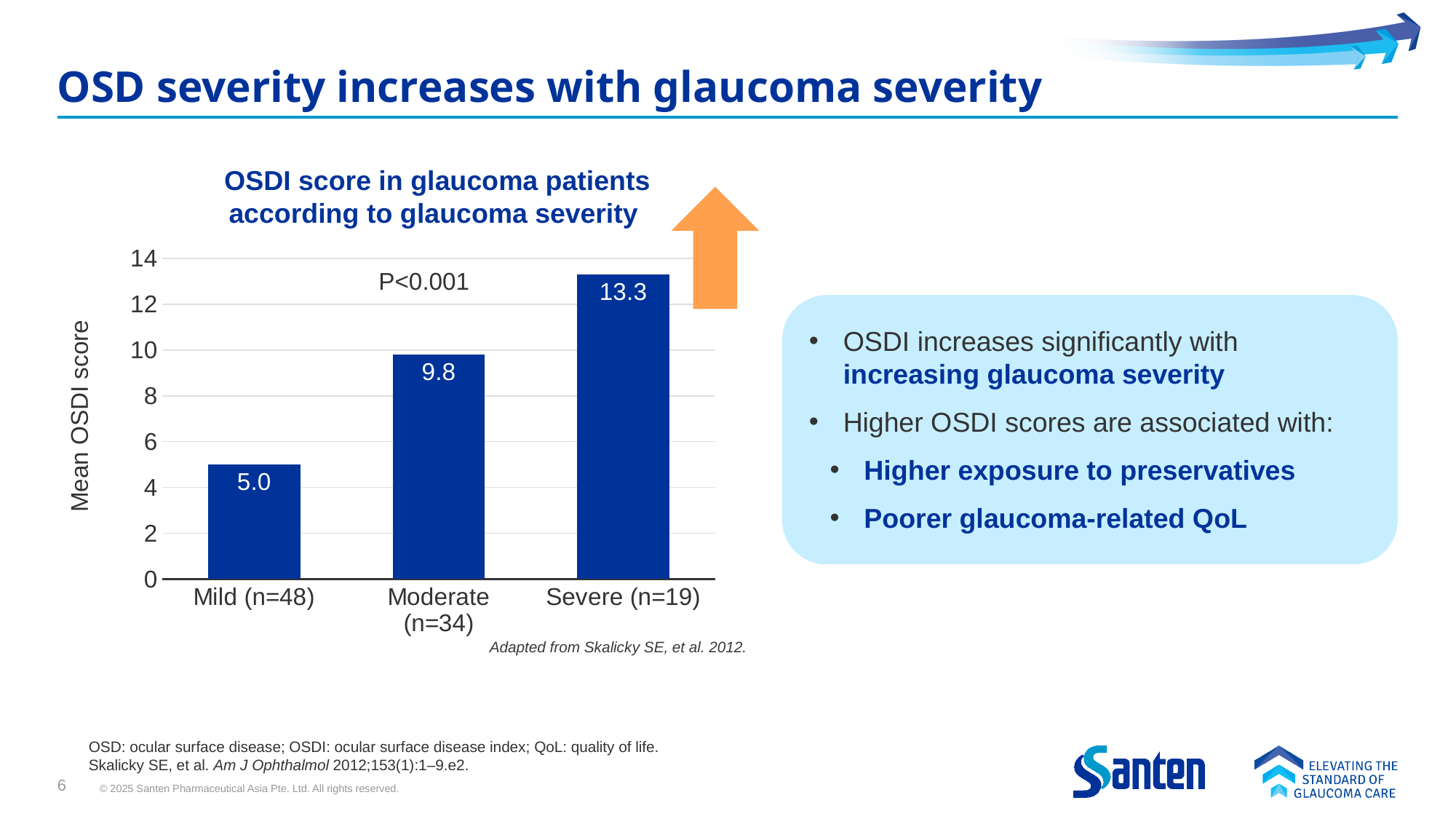
What is the mean OSDI score for the Severe (n=19) group? 13.3 Which glaucoma severity group has the highest mean OSDI score? Severe (n=19) What type of chart is used to show OSDI scores by glaucoma severity? Bar chart What is the difference in mean OSDI score between the Moderate and Mild groups? 4.8 Which group has a higher mean OSDI score, Moderate or Severe? Severe Is the mean OSDI score for the Severe group greater or less than 12? greater How many glaucoma severity groups are shown in the chart? 3 What is the difference in mean OSDI score between the Severe and Mild groups? 8.3 Which glaucoma severity group has the lowest mean OSDI score? Mild (n=48) Do mean OSDI scores rise or fall as glaucoma severity increases from Mild to Severe? Rise What is the mean OSDI score for the Moderate (n=34) group? 9.8 What is the mean OSDI score for the Mild (n=48) group? 5.0